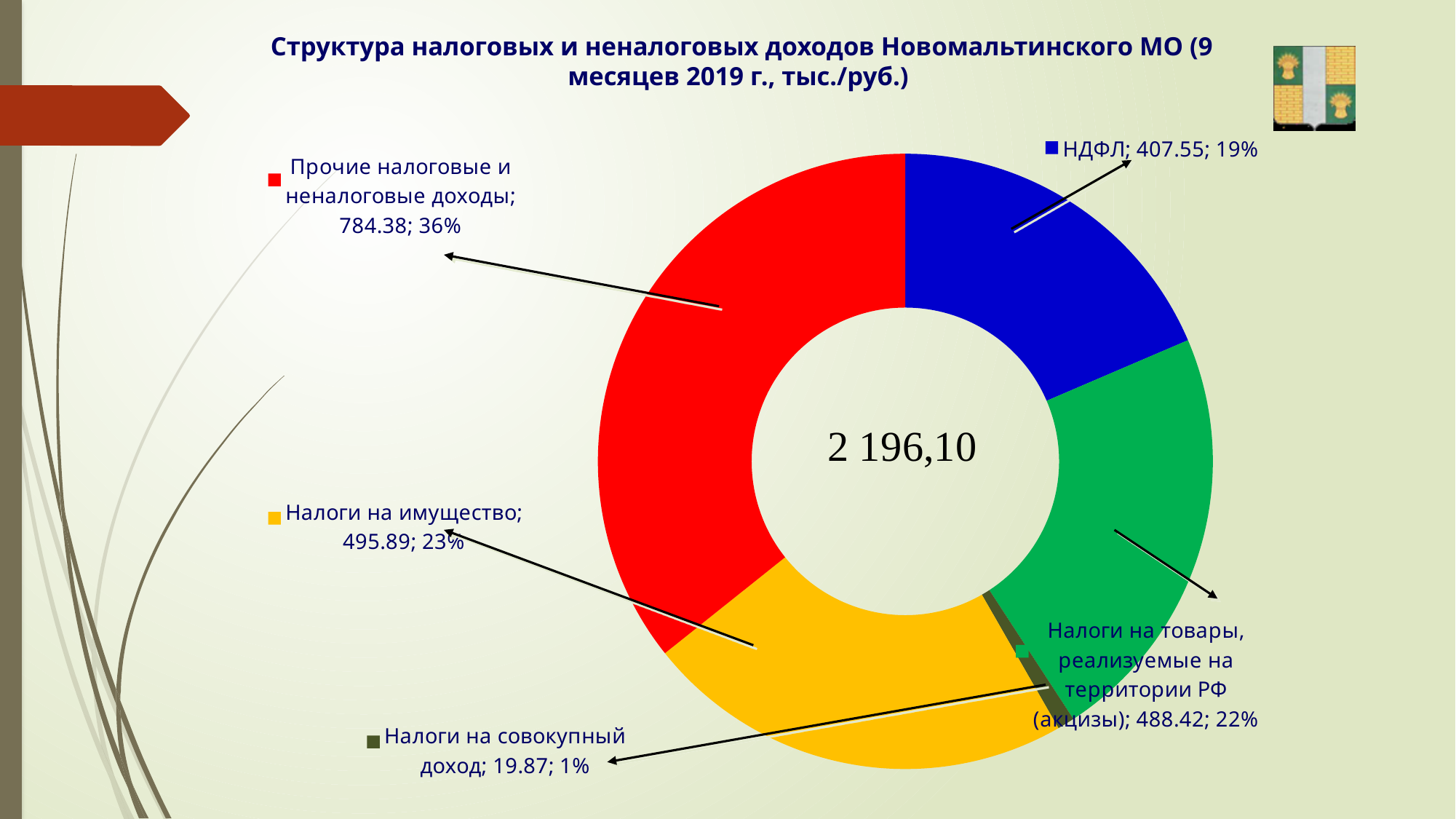
Which category has the largest value? Прочие налоговые и неналоговые доходы What kind of chart is shown on the slide? Doughnut (pie) chart What share of the chart does Прочие налоговые и неналоговые доходы represent? 36% What colour is the segment for Налоги на товары, реализуемые на территории РФ (акцизы)? Green What total is printed in the centre of the doughnut? 2 196,10 What share of the chart does Налоги на имущество represent? 23% Which category has the smallest value? Налоги на совокупный доход What is the value for Налоги на совокупный доход? 19.87 What is the value for НДФЛ? 407.55 Which is larger: the value for Налоги на имущество or the value for НДФЛ? Налоги на имущество How many categories does the chart show? 5 What is the difference between the values for Прочие налоговые и неналоговые доходы and НДФЛ? 376.83